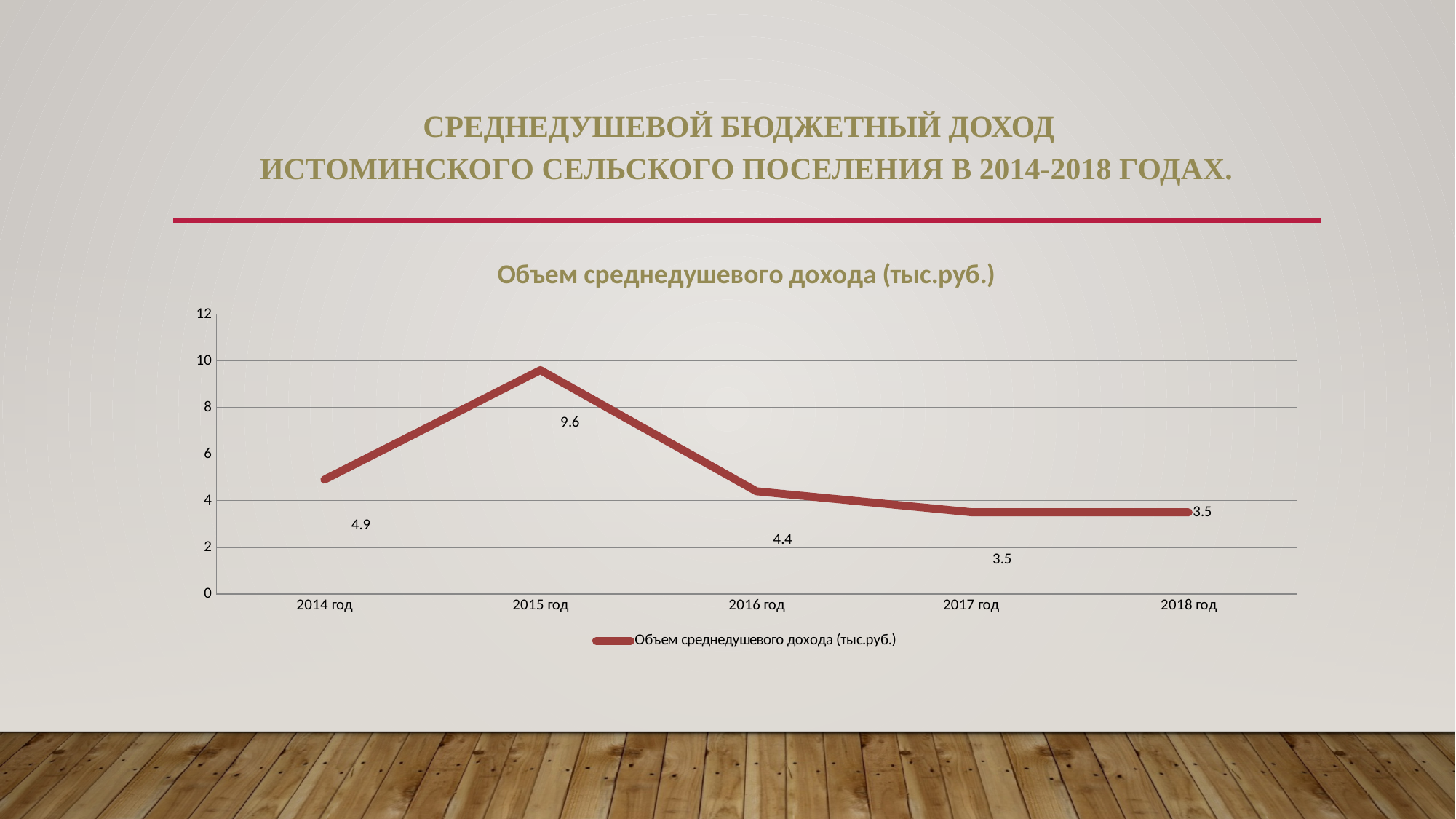
Which is larger, the value for 2014 год or the value for 2016 год? 2014 год What is the difference between the values for 2015 год and 2016 год? 5.2 Is the value for 2015 год greater or less than 8? greater Do the values rise or fall from 2015 год to 2018 год? fall What is the value for 2015 год? 9.6 What is the value for 2016 год? 4.4 What is the value for 2014 год? 4.9 How many series does the legend list? 1 How many years are plotted on the chart? 5 What kind of chart is shown? line chart Which year has the highest value? 2015 год What is the difference between the values for 2014 год and 2018 год? 1.4